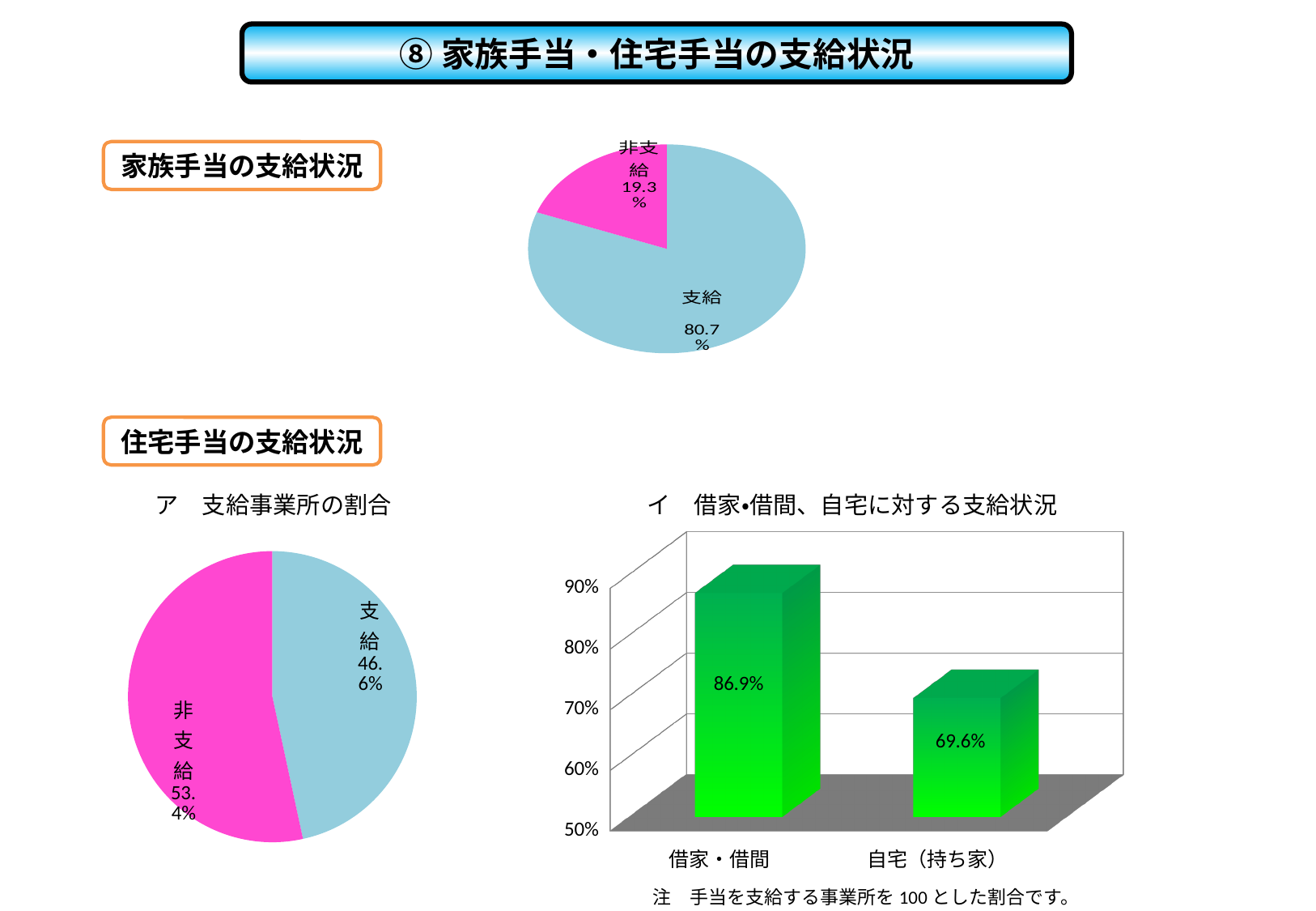
In the bottom-left pie chart (ア 支給事業所の割合), what is the value for 非支給? 53.4% In the bottom-left pie chart (ア 支給事業所の割合), what is the value for 支給? 46.6% In the bottom-left pie chart (ア 支給事業所の割合), which slice is the largest? 非支給 In the top pie chart (家族手当の支給状況), what is the value for 支給? 80.7% In the bottom-left pie chart (ア 支給事業所の割合), how many slices are there? 2 In the bottom-right chart (イ 借家・借間、自宅に対する支給状況), what is the difference between 借家・借間 and 自宅（持ち家）? 17.3% In the top pie chart (家族手当の支給状況), which slice is larger, 支給 or 非支給? 支給 In the bottom-right chart (イ 借家・借間、自宅に対する支給状況), what is the value for 借家・借間? 86.9% What kind of chart is the bottom-right chart (イ 借家・借間、自宅に対する支給状況)? bar chart In the top pie chart (家族手当の支給状況), what is the difference between 支給 and 非支給? 61.4% In the top pie chart (家族手当の支給状況), what is the value for 非支給? 19.3% In the bottom-right chart (イ 借家・借間、自宅に対する支給状況), what is the value for 自宅（持ち家）? 69.6%